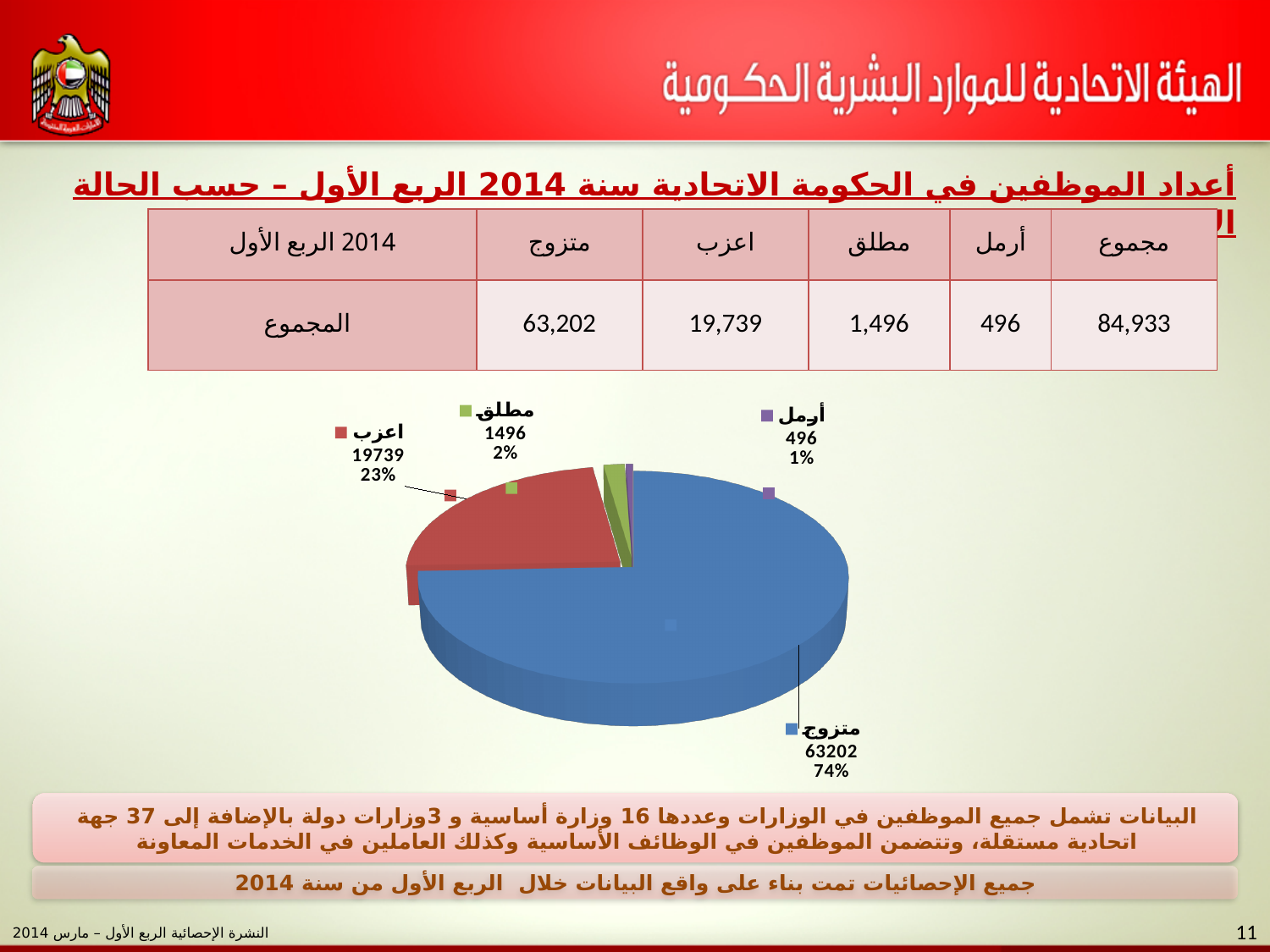
What percentage share does the أرمل (widowed) slice have in the pie chart? 1% Which category has the smallest slice in the pie chart? أرمل Which category has the largest slice in the pie chart? متزوج What value is shown for the متزوج (married) slice in the pie chart? 63202 What is the difference between the متزوج (married) value and the اعزب (single) value in the pie chart? 43463 What percentage share does the اعزب (single) slice have in the pie chart? 23% What type of chart is shown on the slide? pie chart Which is larger in the pie chart, the مطلق (divorced) slice or the أرمل (widowed) slice? مطلق What colour is the متزوج (married) slice in the pie chart? blue What value is shown for the مطلق (divorced) slice in the pie chart? 1496 What percentage share does the متزوج (married) slice have in the pie chart? 74% How many slices does the pie chart have? 4